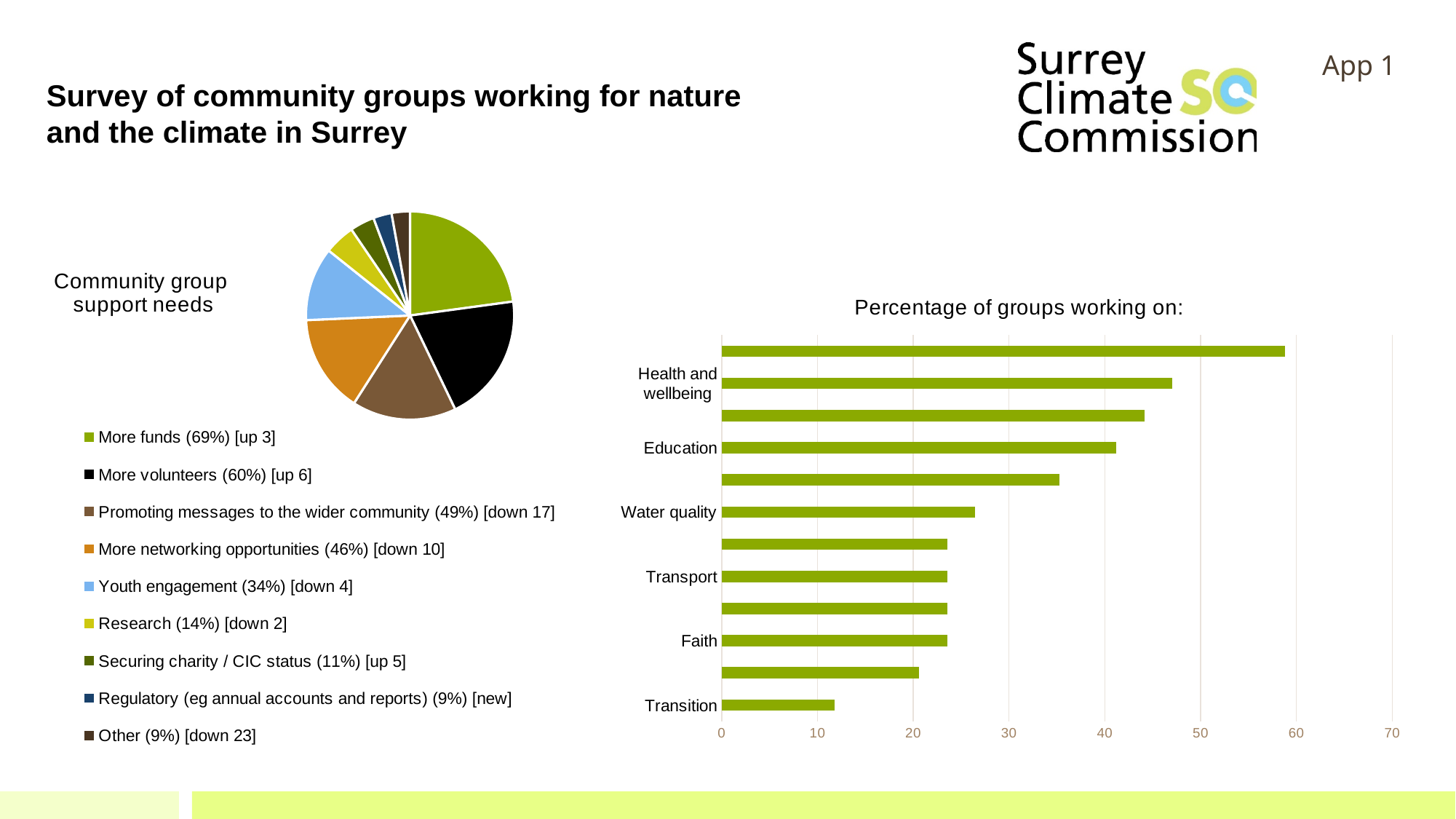
What type of chart is the 'Percentage of groups working on:' chart? bar chart In the 'Community group support needs' pie chart, what percentage is shown for 'More volunteers'? 60% What type of chart is the 'Community group support needs' chart? pie chart In the 'Percentage of groups working on:' bar chart, which is larger: 'Health and wellbeing' or 'Education'? Health and wellbeing In the 'Community group support needs' pie chart, which support need has the largest share? More funds (69%) In the 'Percentage of groups working on:' bar chart, is the value for 'Transition' greater or less than 20? less In the 'Community group support needs' pie chart, which is larger: 'Research' or 'Securing charity / CIC status'? Research In the 'Percentage of groups working on:' bar chart, is the value for 'Health and wellbeing' greater or less than 40? greater How many categories does the legend of the 'Community group support needs' pie chart list? 9 In the 'Community group support needs' pie chart, how many percentage points higher is 'More funds' than 'More volunteers'? 9 In the 'Community group support needs' pie chart, what percentage is shown for 'Youth engagement'? 34% How many bars are plotted in the 'Percentage of groups working on:' bar chart? 12